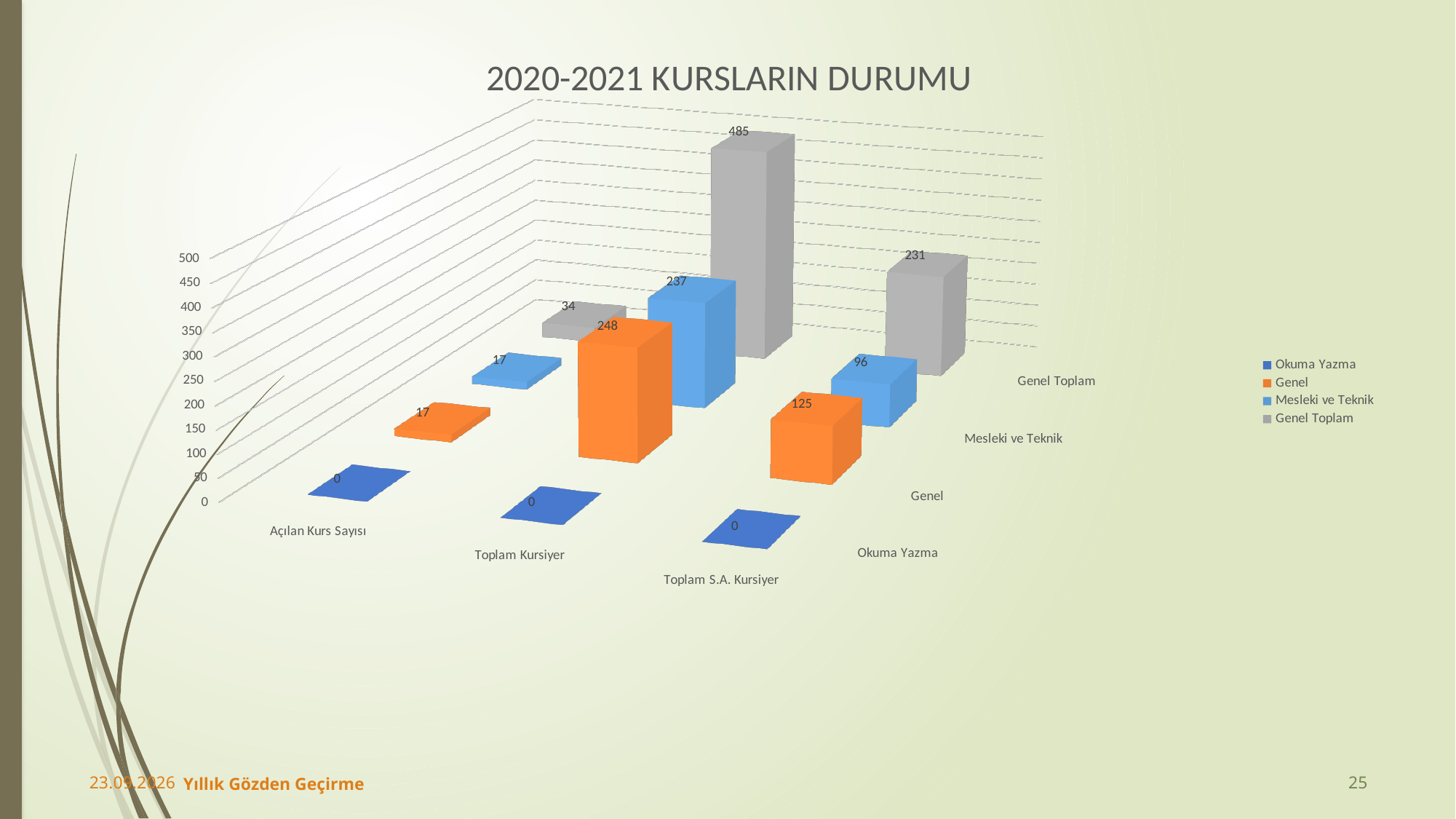
What is the title of the chart? 2020-2021 KURSLARIN DURUMU For Toplam S.A. Kursiyer, which is larger: the Genel value or the Mesleki ve Teknik value? Genel What kind of chart is shown on the slide? bar chart What is the Genel Toplam value for Toplam Kursiyer? 485 What is the Mesleki ve Teknik value for Açılan Kurs Sayısı? 17 How many categories are shown along the x axis? 3 What is the Genel value for Toplam S.A. Kursiyer? 125 How many series does the legend list? 4 Which category has the highest Genel Toplam value? Toplam Kursiyer Which category has the lowest Genel Toplam value? Açılan Kurs Sayısı What is the difference between the Genel and Mesleki ve Teknik values for Toplam Kursiyer? 11 What is the Okuma Yazma value for Toplam Kursiyer? 0